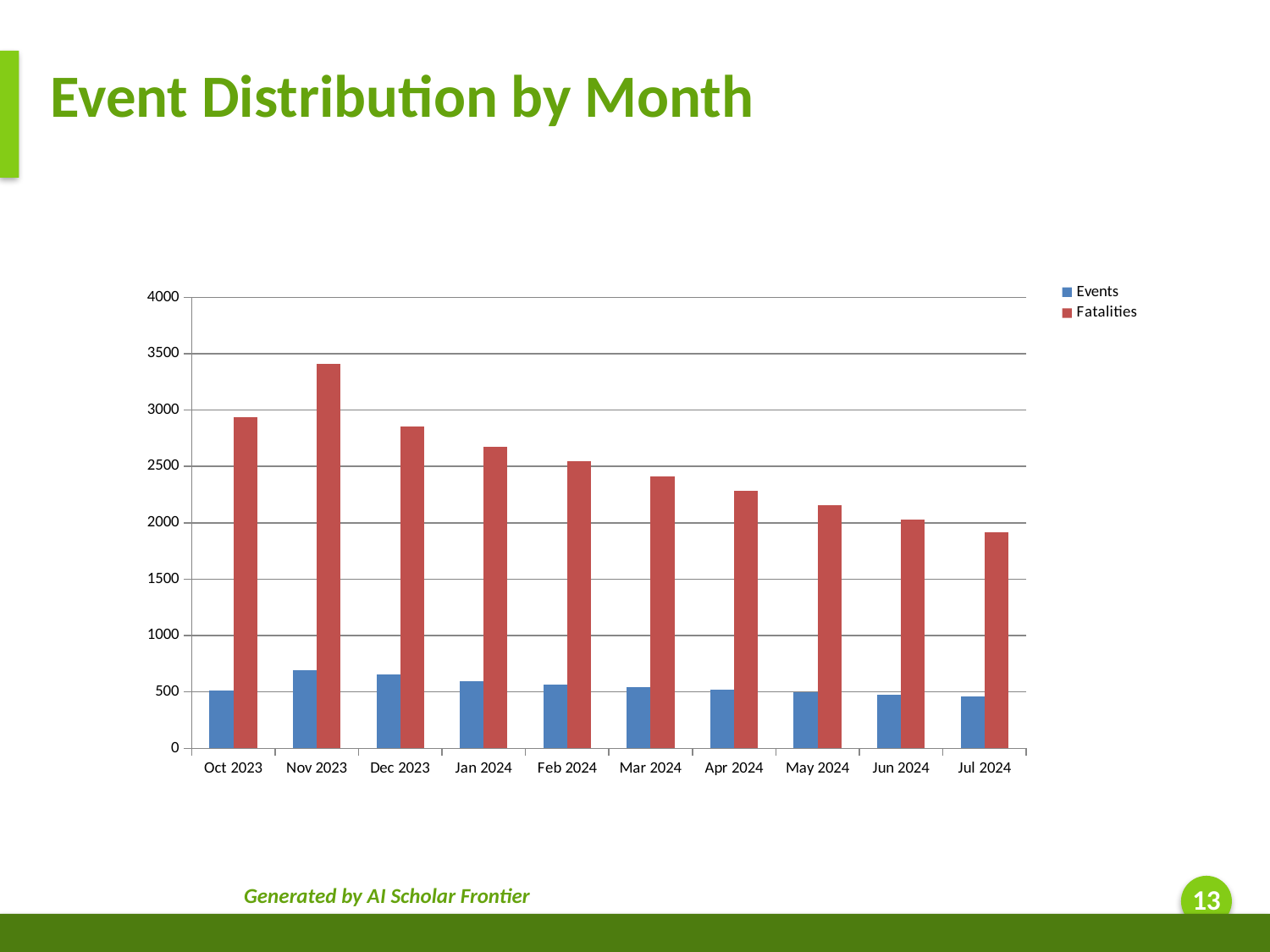
How many months are shown on the x axis? 10 How many series does the legend list? 2 Is the Events value for Nov 2023 greater or less than 500? greater Which month has the highest Events value? Nov 2023 Is the Fatalities value for Jul 2024 greater or less than 2000? less From Nov 2023 to Jul 2024, do the Fatalities values rise or fall? fall Which month has the lowest Fatalities value? Jul 2024 Is the Fatalities value for Mar 2024 greater or less than 2500? less What kind of chart is shown on the slide? bar chart Which month has the highest Fatalities value? Nov 2023 Which is larger, the Fatalities value for Dec 2023 or for Jan 2024? Dec 2023